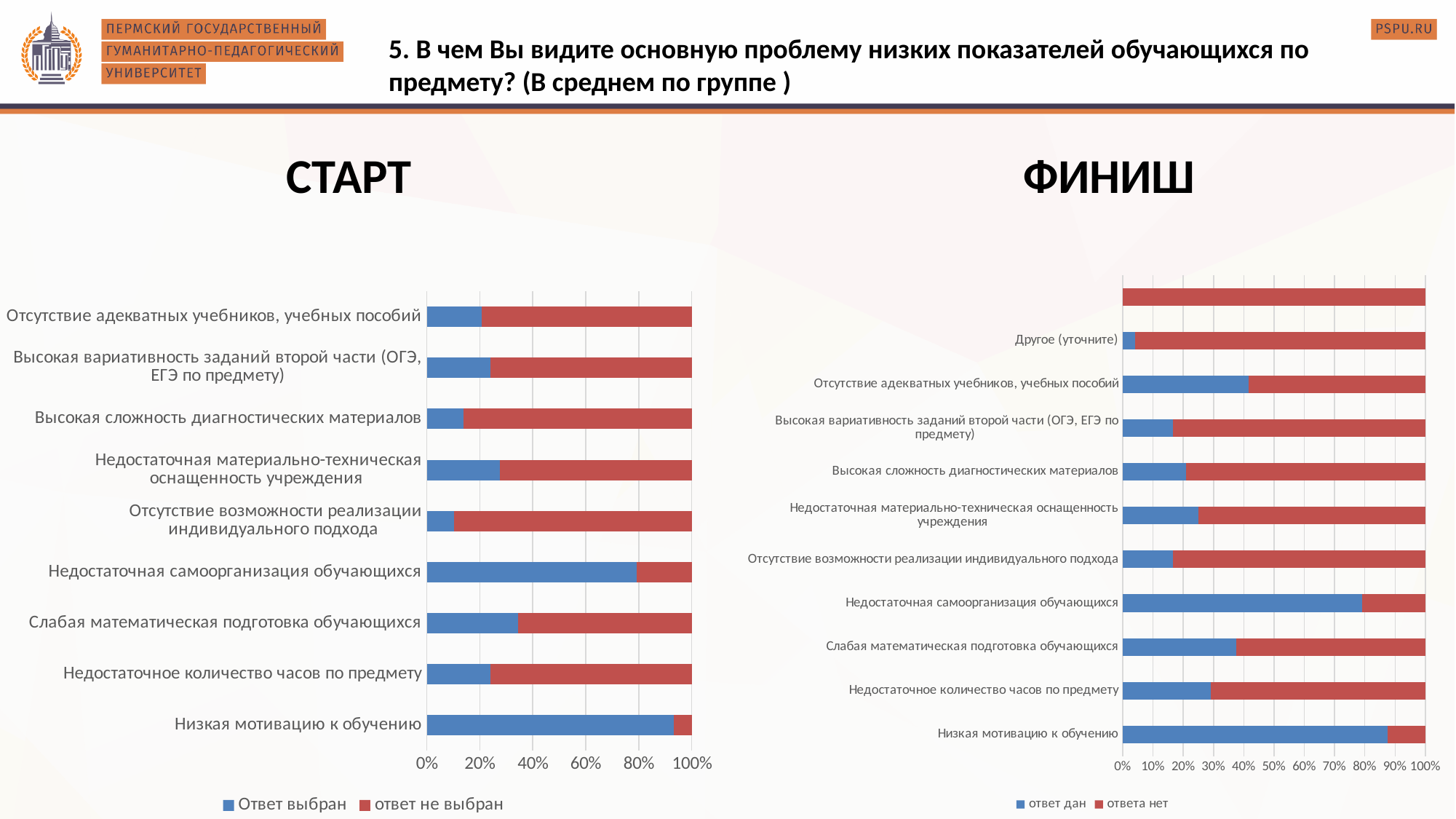
On the СТАРТ chart, which category has the highest share of 'Ответ выбран'? Низкая мотивацию к обучению On the ФИНИШ chart, is the 'ответ дан' value for 'Другое (уточните)' greater or less than 10%? less On the ФИНИШ chart, which has a larger 'ответ дан' share: 'Отсутствие адекватных учебников, учебных пособий' or 'Высокая вариативность заданий второй части (ОГЭ, ЕГЭ по предмету)'? Отсутствие адекватных учебников, учебных пособий On the СТАРТ chart, is the 'Ответ выбран' value for 'Низкая мотивацию к обучению' greater or less than 80%? greater On the СТАРТ chart, is the 'Ответ выбран' value for 'Высокая сложность диагностических материалов' greater or less than 20%? less What are the two legend entries of the СТАРТ chart on the left? Ответ выбран; ответ не выбран How many categories are shown on the СТАРТ chart on the left? 9 What kind of chart is the СТАРТ chart on the left? Stacked bar chart On the СТАРТ chart, which has a larger 'Ответ выбран' share: 'Недостаточная самоорганизация обучающихся' or 'Слабая математическая подготовка обучающихся'? Недостаточная самоорганизация обучающихся How many series does the legend of the ФИНИШ chart on the right list? 2 What colour represents 'ответа нет' on the ФИНИШ chart? Red